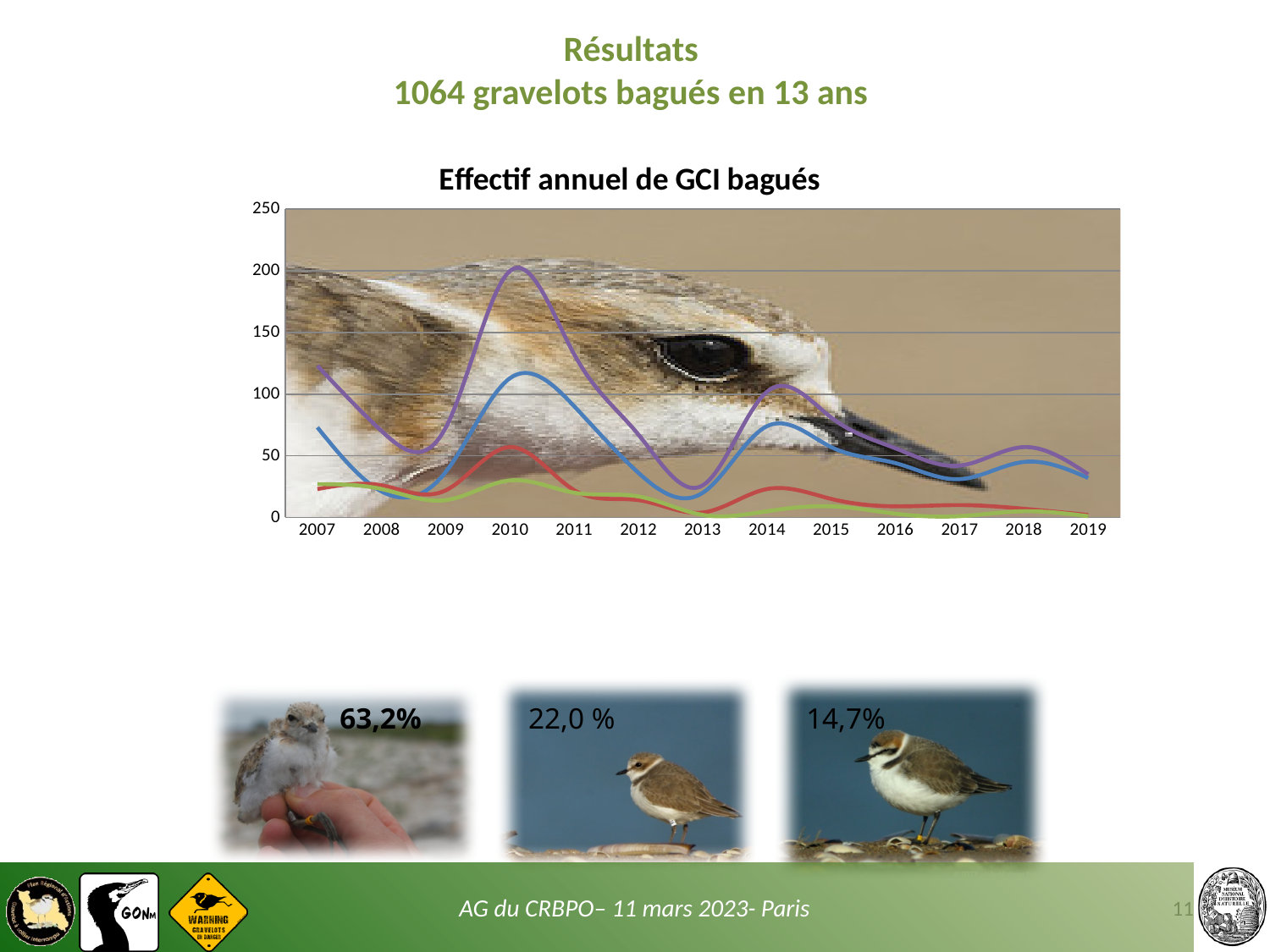
Is the value of the blue line in 2010 greater or less than 100? greater In which year does the blue line reach its highest value? 2010 How many lines are plotted on the chart? 4 In which year does the purple line reach its highest value? 2010 How many years are shown on the x axis of the chart? 13 Is the value of the purple line in 2013 greater or less than 50? less Is the value of the purple line in 2010 greater or less than 150? greater What kind of chart is 'Effectif annuel de GCI bagués'? line chart Does the purple line rise or fall between 2010 and 2013? fall What is the title of the chart on the slide? Effectif annuel de GCI bagués In 2010, which line has the larger value, the purple line or the blue line? purple line